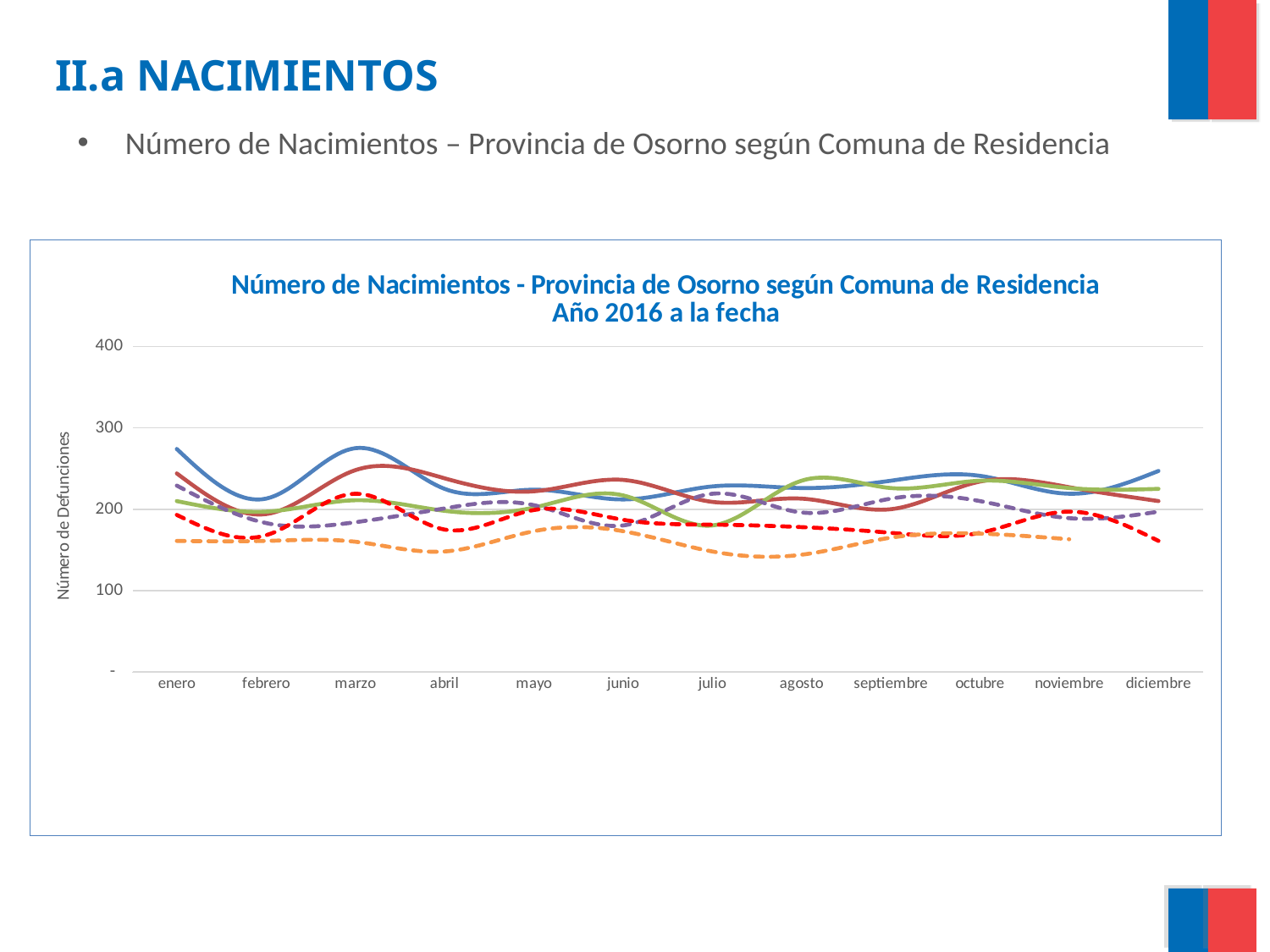
In agosto, which is larger: the solid green line or the dashed orange line? the solid green line What kind of chart is shown on the slide? line chart How many lines are plotted in the chart? 6 In enero, which is larger: the solid blue line or the dashed orange line? the solid blue line What is the title of the chart? Número de Nacimientos - Provincia de Osorno según Comuna de Residencia Año 2016 a la fecha How many months are shown along the x axis of the chart? 12 Is the value of the dashed red line in diciembre greater or less than 200? less Is the value of the solid blue line in marzo greater or less than 300? less What is the label on the vertical axis of the chart? Número de Defunciones Is the value of the solid blue line in enero greater or less than 200? greater